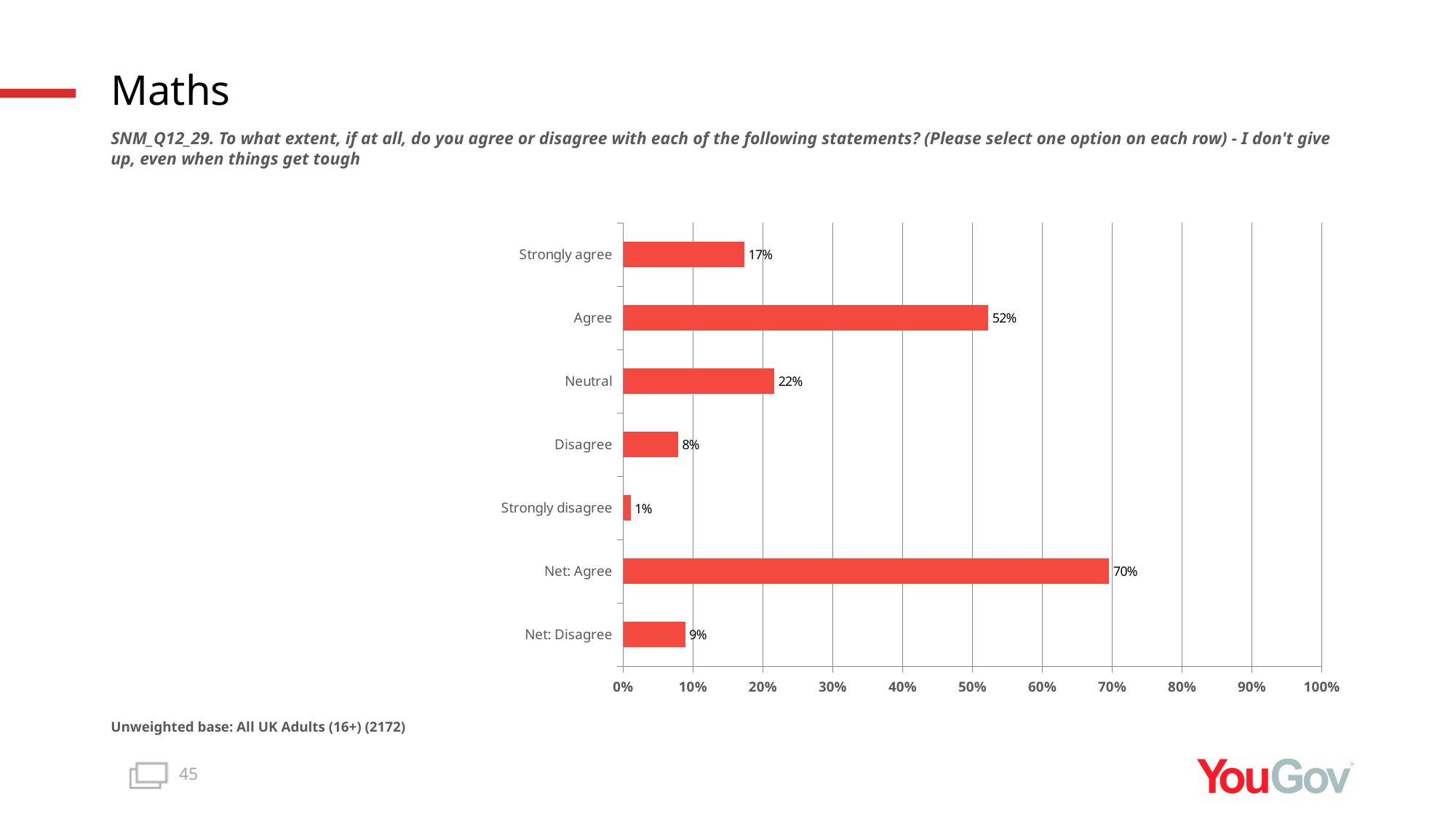
What kind of chart is shown on the slide? Bar chart What is the value shown for 'Strongly disagree'? 1% What is the difference between 'Agree' and 'Strongly agree'? 35% Which category has the lowest value? Strongly disagree Is the value for 'Agree' greater or less than 50%? greater What percentage of respondents selected 'Agree'? 52% What is the value for 'Net: Agree'? 70% Which is larger, 'Neutral' or 'Strongly agree'? Neutral How many categories are shown on the chart? 7 What is the unweighted base stated on the slide? All UK Adults (16+) (2172) Which category has the highest value? Net: Agree What is the difference between 'Net: Agree' and 'Net: Disagree'? 61%